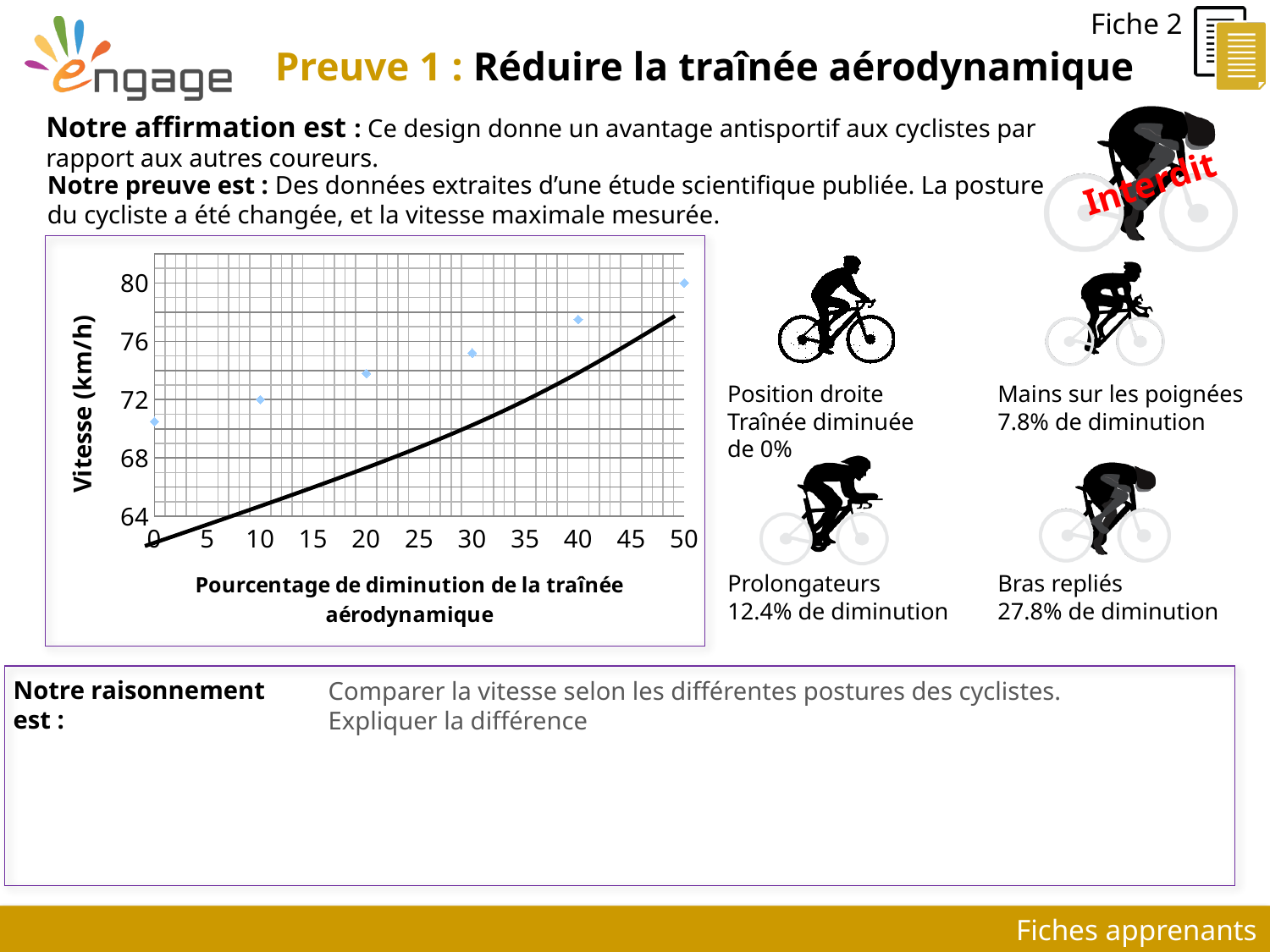
How many data points are plotted on the chart? 6 What is the speed (km/h) plotted at 50% drag reduction? 80 At which percentage of drag reduction is the plotted speed highest? 50 Which has the higher plotted speed: 40% drag reduction or 10% drag reduction? 40% What is the speed (km/h) plotted at 10% drag reduction? 72 Do the plotted speed values rise or fall as the percentage of drag reduction increases? rise What kind of chart is shown on the slide? scatter chart What is the title of the vertical axis of the chart? Vitesse (km/h) Is the speed plotted at 0% drag reduction greater or less than 72 km/h? less Is the speed plotted at 40% drag reduction greater or less than 76 km/h? greater Is the speed plotted at 20% drag reduction greater or less than 72 km/h? greater At which percentage of drag reduction is the plotted speed lowest? 0